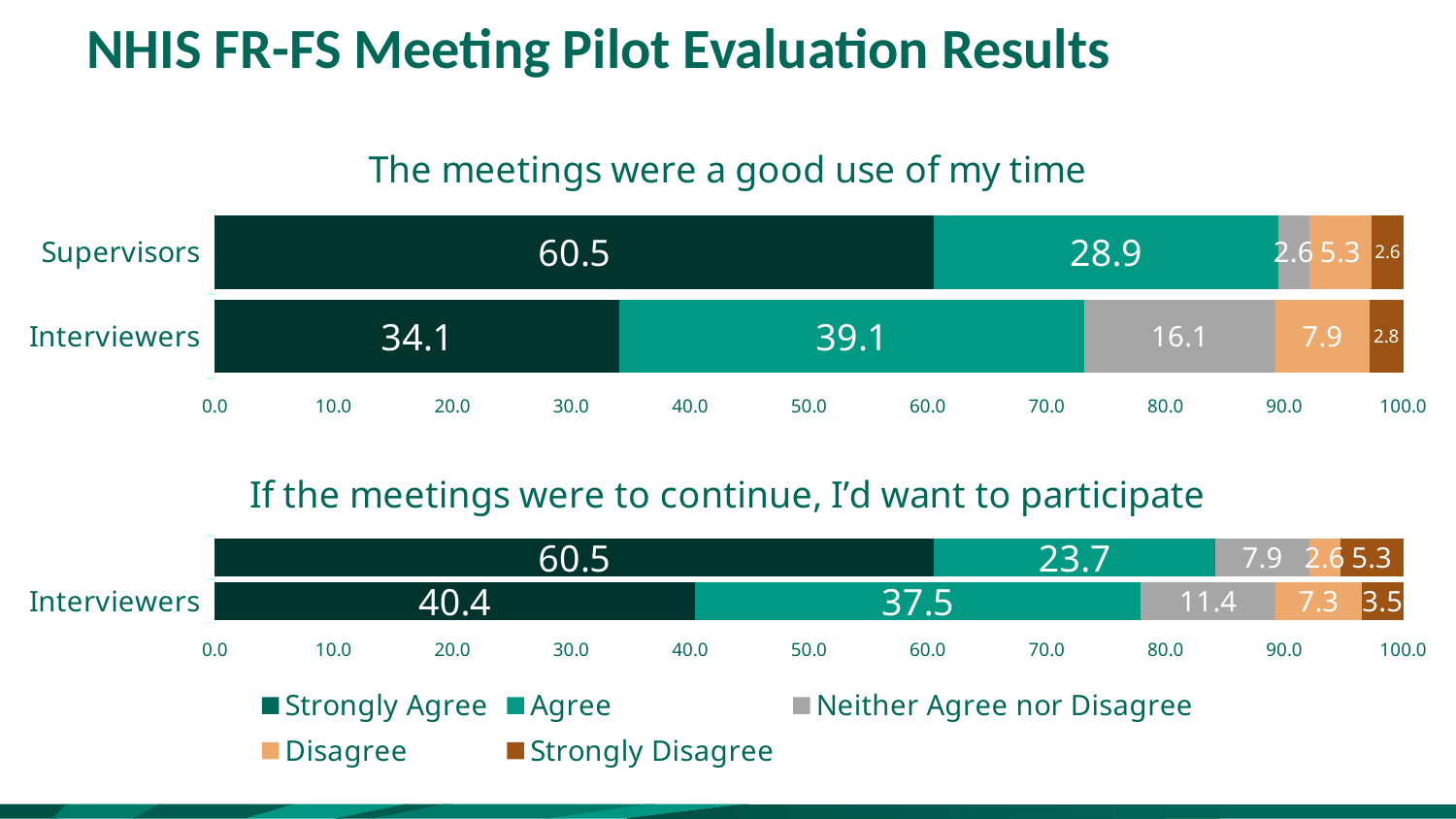
In the chart titled "The meetings were a good use of my time", what is the Strongly Agree value for Supervisors? 60.5 In the chart titled "The meetings were a good use of my time", what is the Agree value for Interviewers? 39.1 In the chart titled "The meetings were a good use of my time", what is the Neither Agree nor Disagree value for Interviewers? 16.1 In the chart titled "If the meetings were to continue, I'd want to participate", what is the Strongly Disagree value for Interviewers? 3.5 In the chart titled "If the meetings were to continue, I'd want to participate", what is the Strongly Agree value for Interviewers? 40.4 In the chart titled "The meetings were a good use of my time", what is the Disagree value for Supervisors? 5.3 What kind of chart is the chart titled "The meetings were a good use of my time"? Stacked bar chart How many series does the legend list for the charts on this slide? 5 In the chart titled "If the meetings were to continue, I'd want to participate", what is the Neither Agree nor Disagree value for Interviewers? 11.4 In the chart titled "The meetings were a good use of my time", what is the difference between the Strongly Agree values for Supervisors and Interviewers? 26.4 In the chart titled "The meetings were a good use of my time", which group has the higher Strongly Agree value, Supervisors or Interviewers? Supervisors In the chart titled "If the meetings were to continue, I'd want to participate", which response category has the lowest value for Interviewers? Strongly Disagree